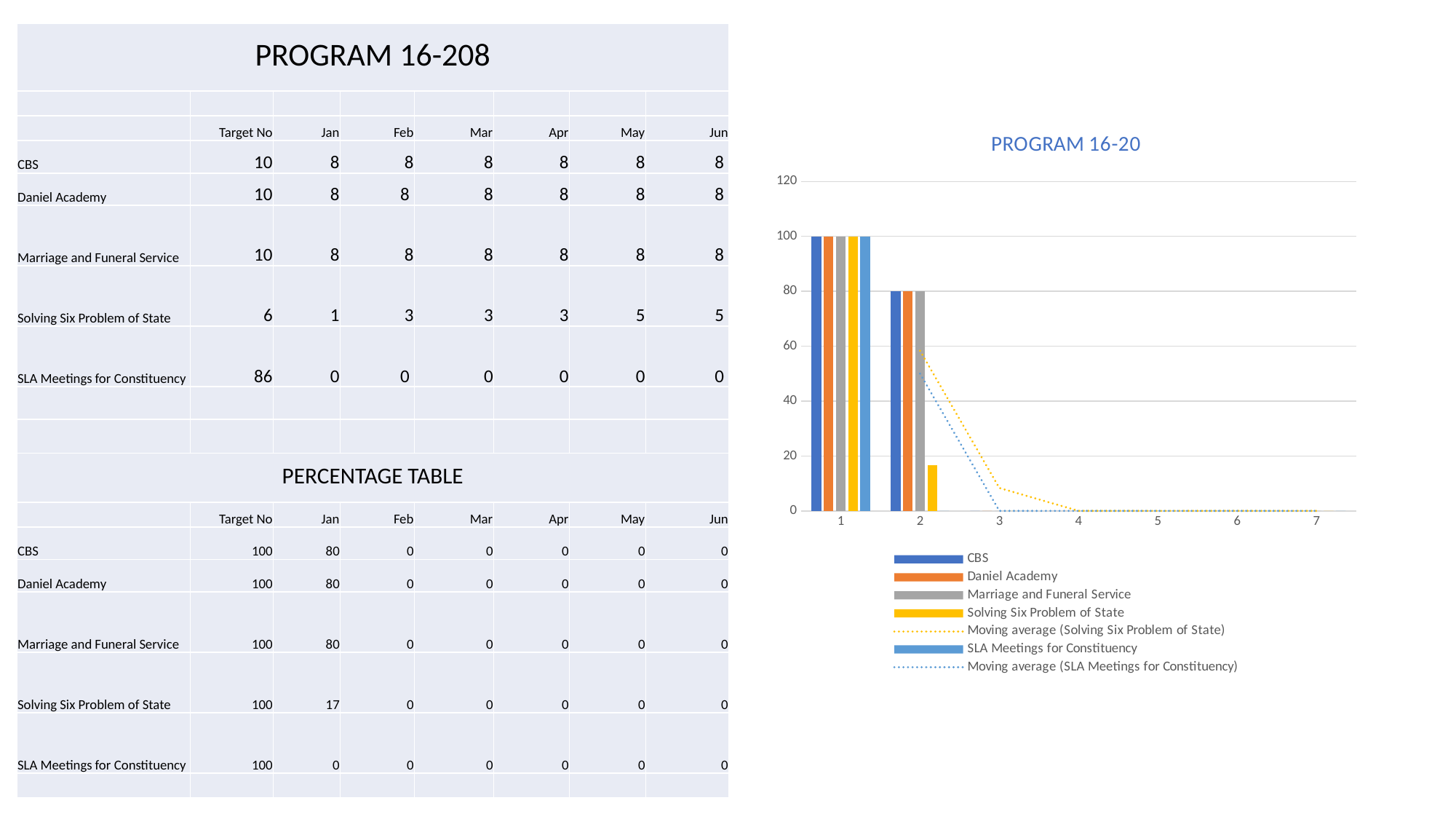
What is the title of the chart on the right side of the slide? PROGRAM 16-20 In the PROGRAM 16-20 chart, which is larger: the CBS bar at category 1 or the CBS bar at category 2? category 1 What kind of chart is the PROGRAM 16-20 chart? bar chart In the PROGRAM 16-20 chart, what is the difference between the CBS bar at category 1 and the CBS bar at category 2? 20 In the PROGRAM 16-20 chart, is the Daniel Academy bar at category 2 greater or less than 100? less In the PROGRAM 16-20 chart, what is the value of the Marriage and Funeral Service bar at category 2? 80 In the PROGRAM 16-20 chart, is the value of the Solving Six Problem of State bar at category 2 greater or less than 20? less How many categories are shown on the x axis of the PROGRAM 16-20 chart? 7 How many entries does the legend of the PROGRAM 16-20 chart list? 7 In the PROGRAM 16-20 chart, does the Moving average (Solving Six Problem of State) line rise or fall from category 2 to category 4? fall In the PROGRAM 16-20 chart, what is the value of the CBS bar at category 1? 100